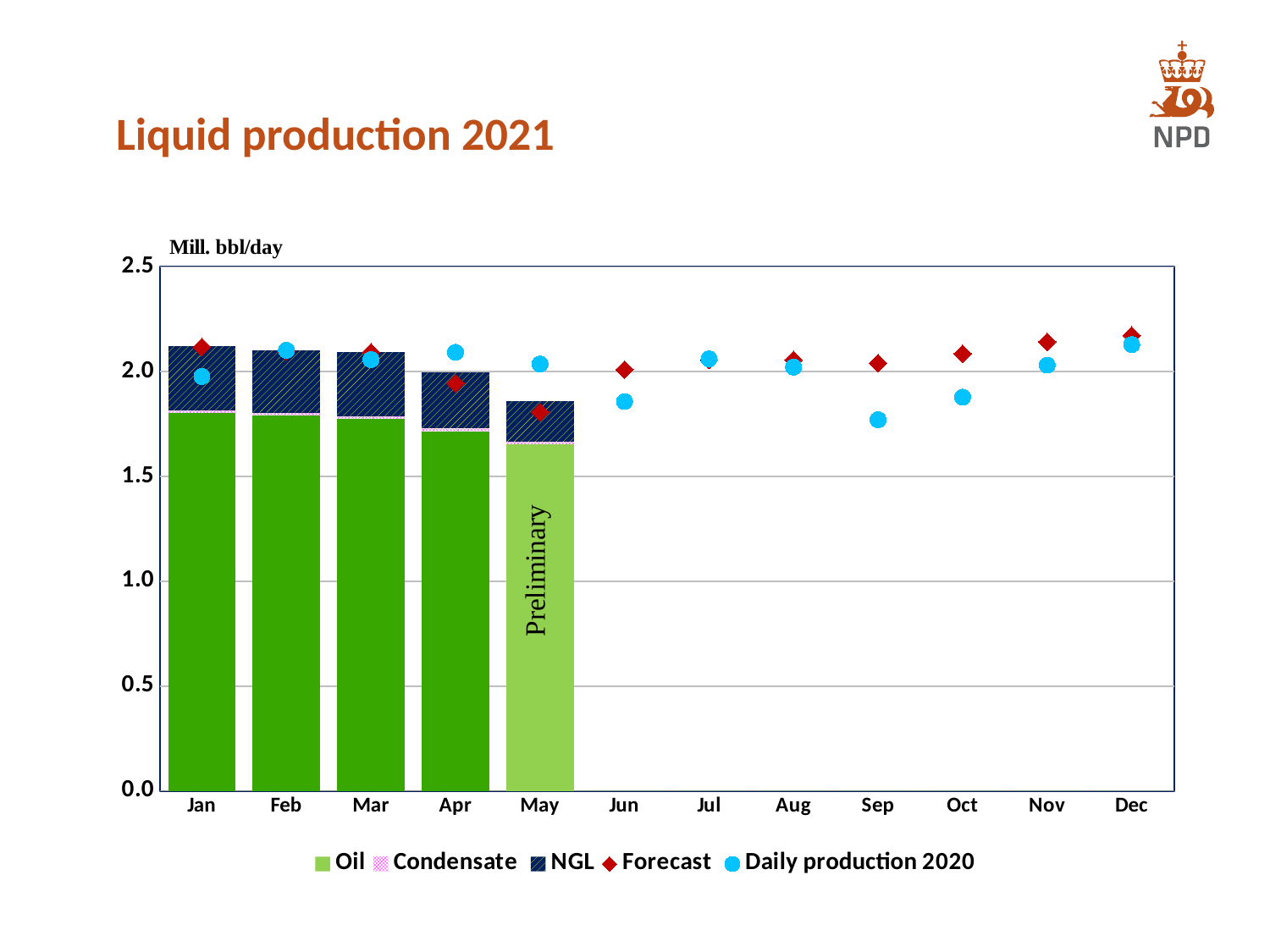
Is the Daily production 2020 value for Sep greater or less than 2.0? less Which month has the lowest Forecast value? May How many series does the legend list? 5 Which month's bar is labelled "Preliminary"? May In Sep, which is higher: the Forecast or the Daily production 2020 value? Forecast Is the total stacked bar for May greater or less than 2.0? less Which month has the lowest Daily production 2020 value? Sep Do the stacked bars rise or fall from Jan to May? fall How many months are shown on the x axis? 12 Is the total stacked bar for Jan greater or less than 2.0? greater Which month has the lowest stacked bar? May What kind of chart is shown on the slide? combination chart (stacked bars with point markers)